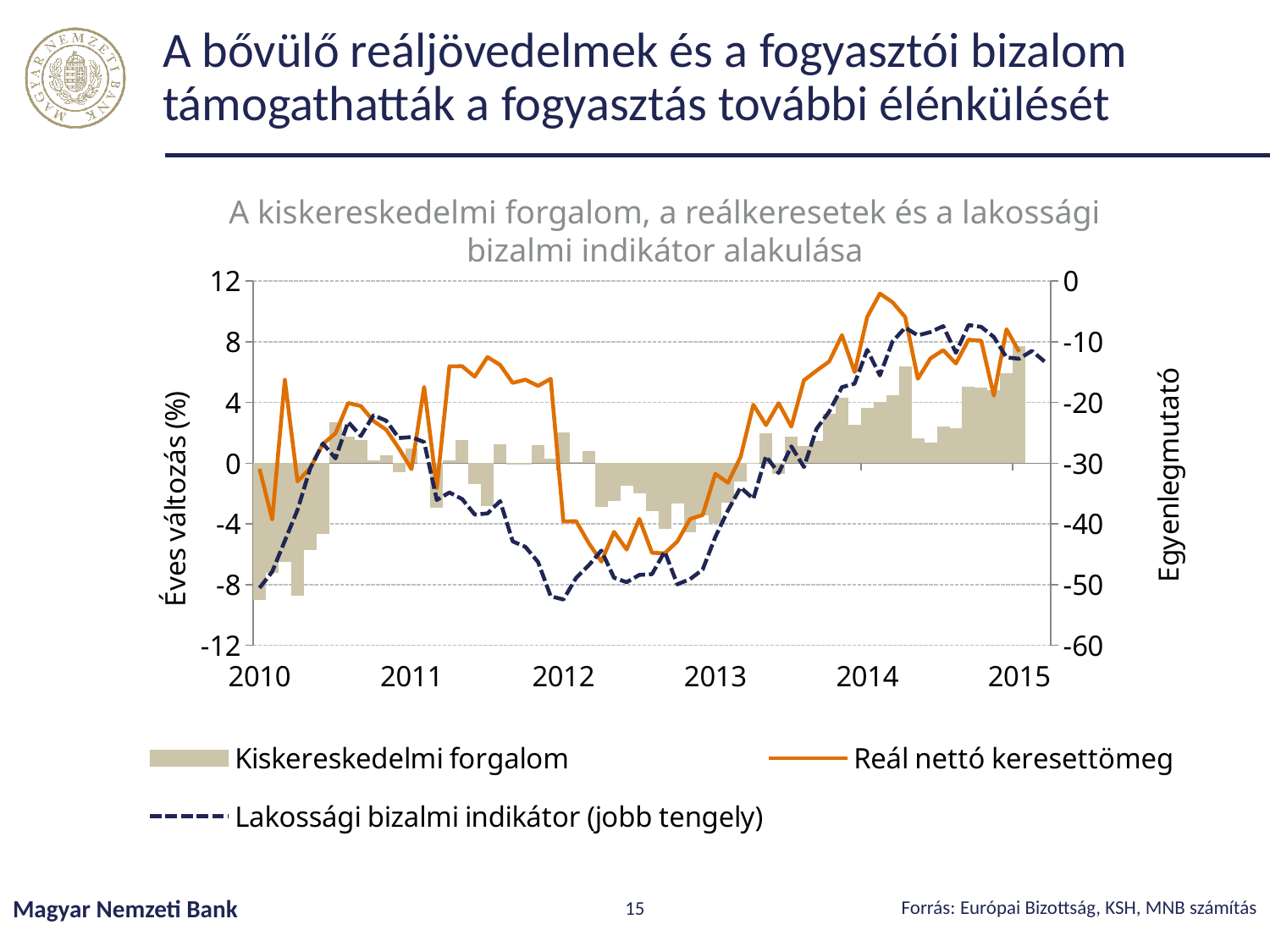
Does Kiskereskedelmi forgalom rise or fall between 2013 and 2015? rise Does the Lakossági bizalmi indikátor rise or fall between 2012 and 2014? rise Is the value of Kiskereskedelmi forgalom at the start of 2010 greater or less than -4? less How many year labels are shown on the x axis? 6 What is the title of the chart? A kiskereskedelmi forgalom, a reálkeresetek és a lakossági bizalmi indikátor alakulása In which year does Reál nettó keresettömeg reach its highest value? 2014 Is the value of Lakossági bizalmi indikátor in mid-2014 greater or less than -20? greater Is the value of Lakossági bizalmi indikátor at the start of 2012 greater or less than -40? less Which series is plotted on the right axis? Lakossági bizalmi indikátor How many series does the chart legend list? 3 What kind of chart is shown on the slide? Combined bar and line chart